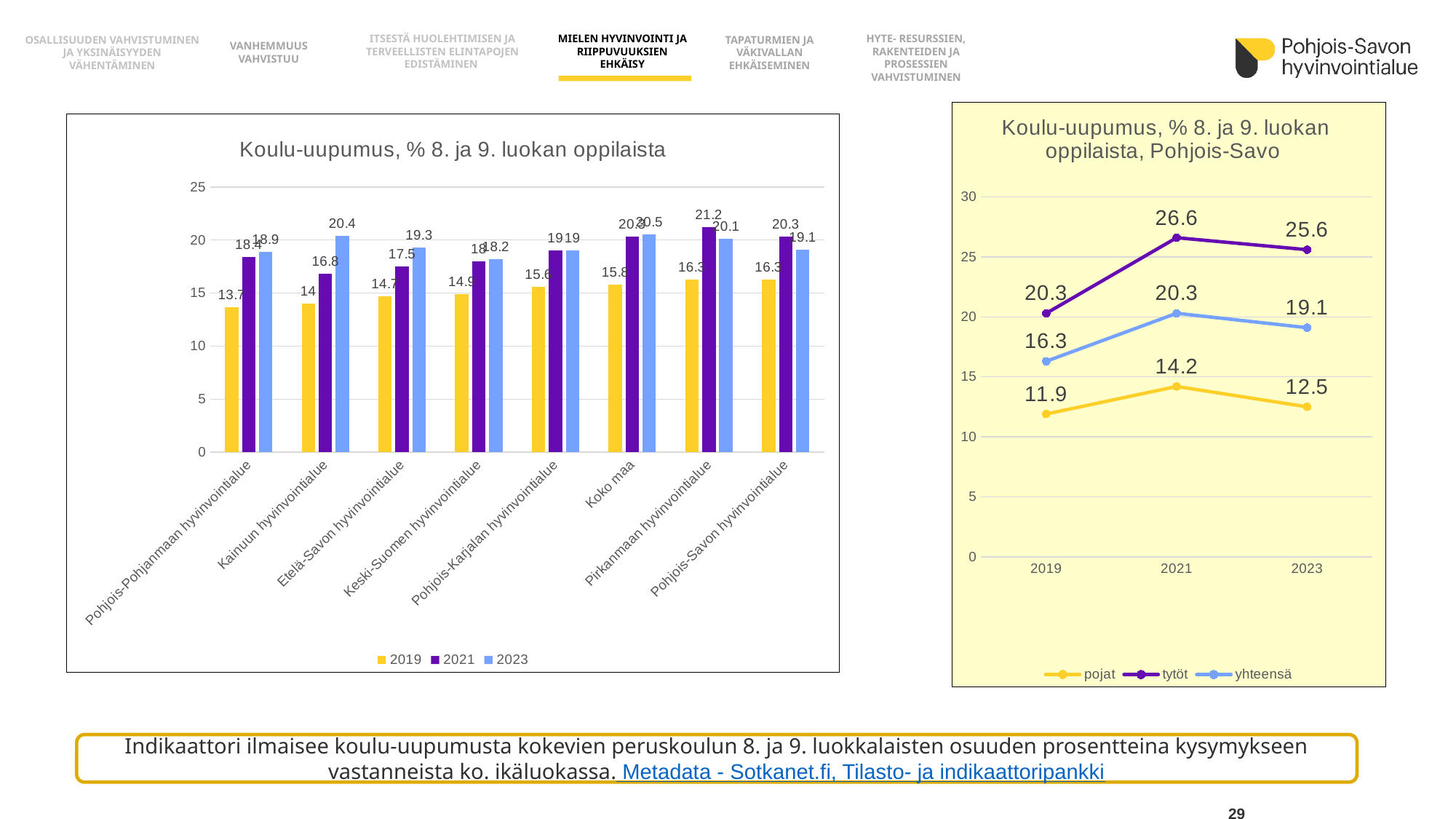
What kind of chart is the chart on the right, titled 'Koulu-uupumus, % 8. ja 9. luokan oppilaista, Pohjois-Savo'? line chart In the left chart, what is the 2019 value for Pohjois-Pohjanmaan hyvinvointialue? 13.7 In the right chart, is the value for pojat in 2019 greater or less than 15? less In the right chart, what is the value for tytöt in 2021? 26.6 In the left chart, what is the difference between the 2023 and 2019 values for Etelä-Savon hyvinvointialue? 4.6 In the left chart, how many categories are shown on the x axis? 8 In the left chart, which category has the highest 2021 value? Pirkanmaan hyvinvointialue In the left chart, how many series does the legend list? 3 In the right chart, what is the difference between tytöt and pojat in 2023? 13.1 In the left chart, which category has the lowest 2019 value? Pohjois-Pohjanmaan hyvinvointialue In the left chart, what is the 2023 value for Kainuun hyvinvointialue? 20.4 In the left chart, what is the 2021 value for Pirkanmaan hyvinvointialue? 21.2